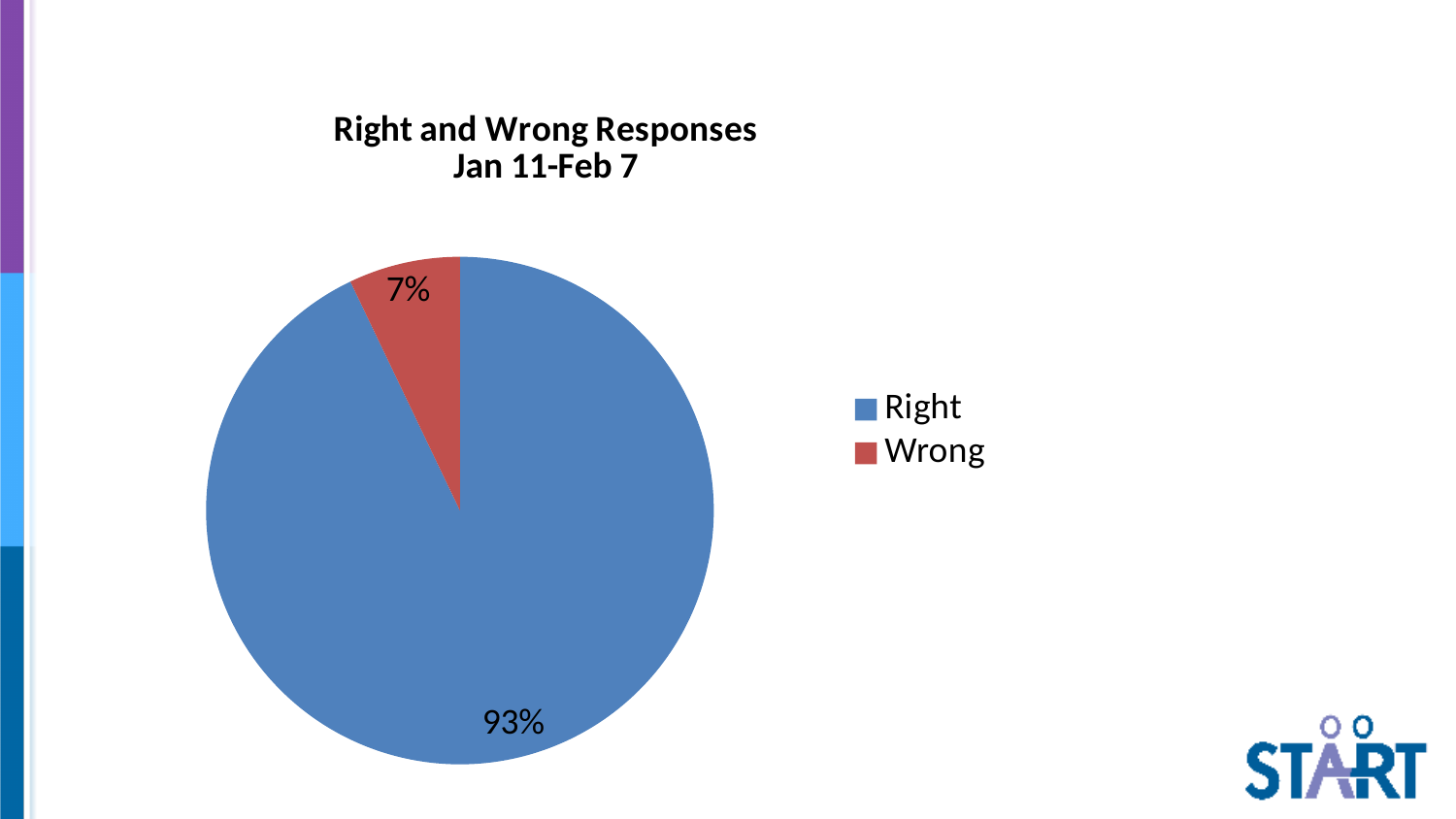
What is the difference in percentage points between the Right and Wrong shares? 86 What colour is the Wrong slice? red Which category has the largest share of the pie? Right How many slices does the pie chart have? 2 What percentage of responses were Wrong? 7% Which category has the smallest share of the pie? Wrong How many entries does the legend list? 2 Which is larger, the share for Right or the share for Wrong? Right What share of the pie does the Right slice represent? 93% What is the title of the chart? Right and Wrong Responses Jan 11-Feb 7 What percentage of responses were Right? 93% What kind of chart is shown on the slide? pie chart